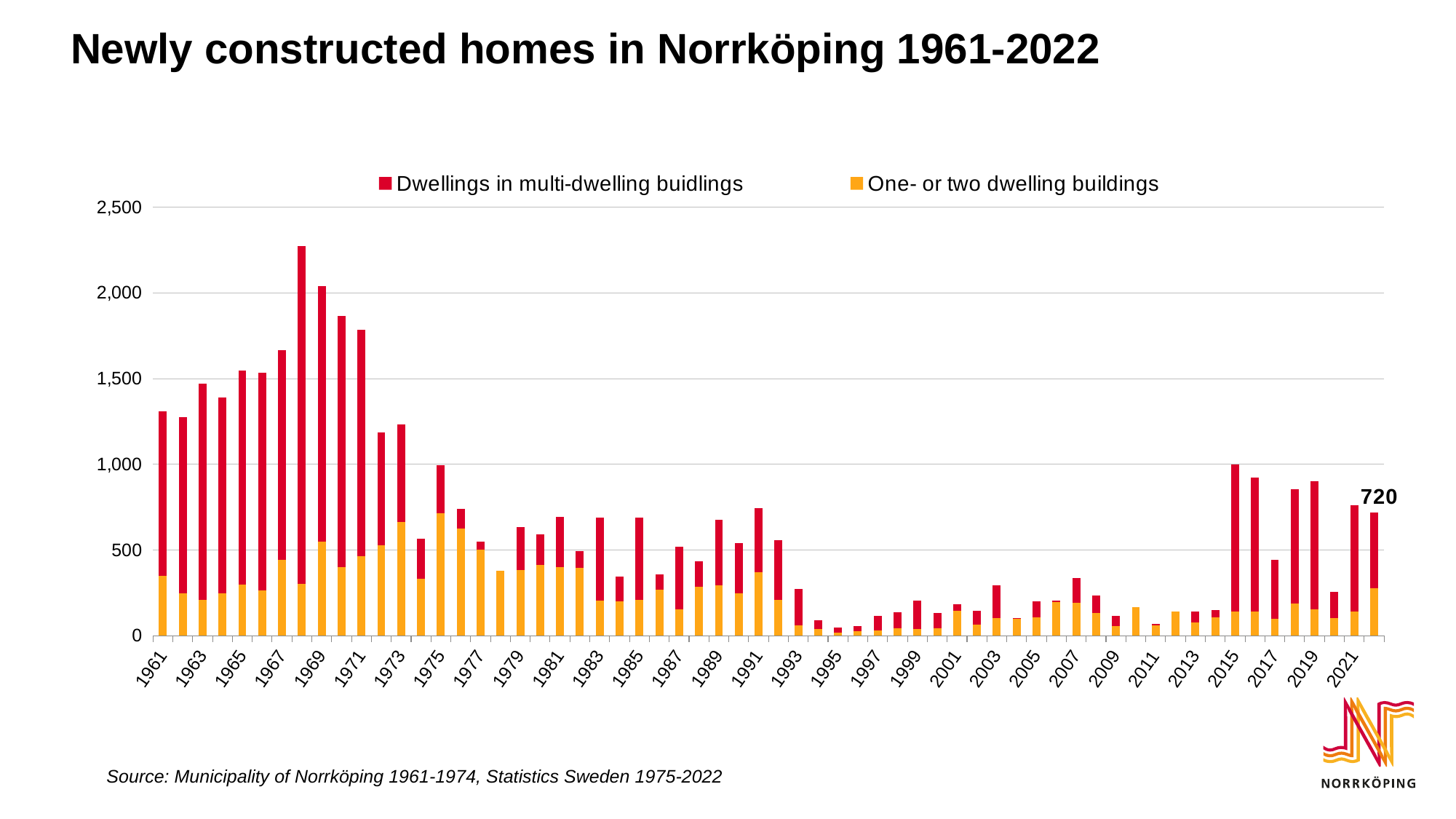
What kind of chart is shown on the slide? stacked bar chart Do the totals generally rise or fall from 1968 to 1978? fall Which year has the larger total of newly constructed homes, 1961 or 1968? 1968 Which colour represents 'One- or two dwelling buildings' in the chart? orange Is the total value for 1978 greater or less than 500? less How many series does the legend list? 2 Is the total value for 1995 greater or less than 100? less Which year has the highest total of newly constructed homes? 1968 Is the total value for 1961 greater or less than 1,000? greater What is the total number of newly constructed homes shown for 2022? 720 Which year has the larger total of newly constructed homes, 2015 or 2017? 2015